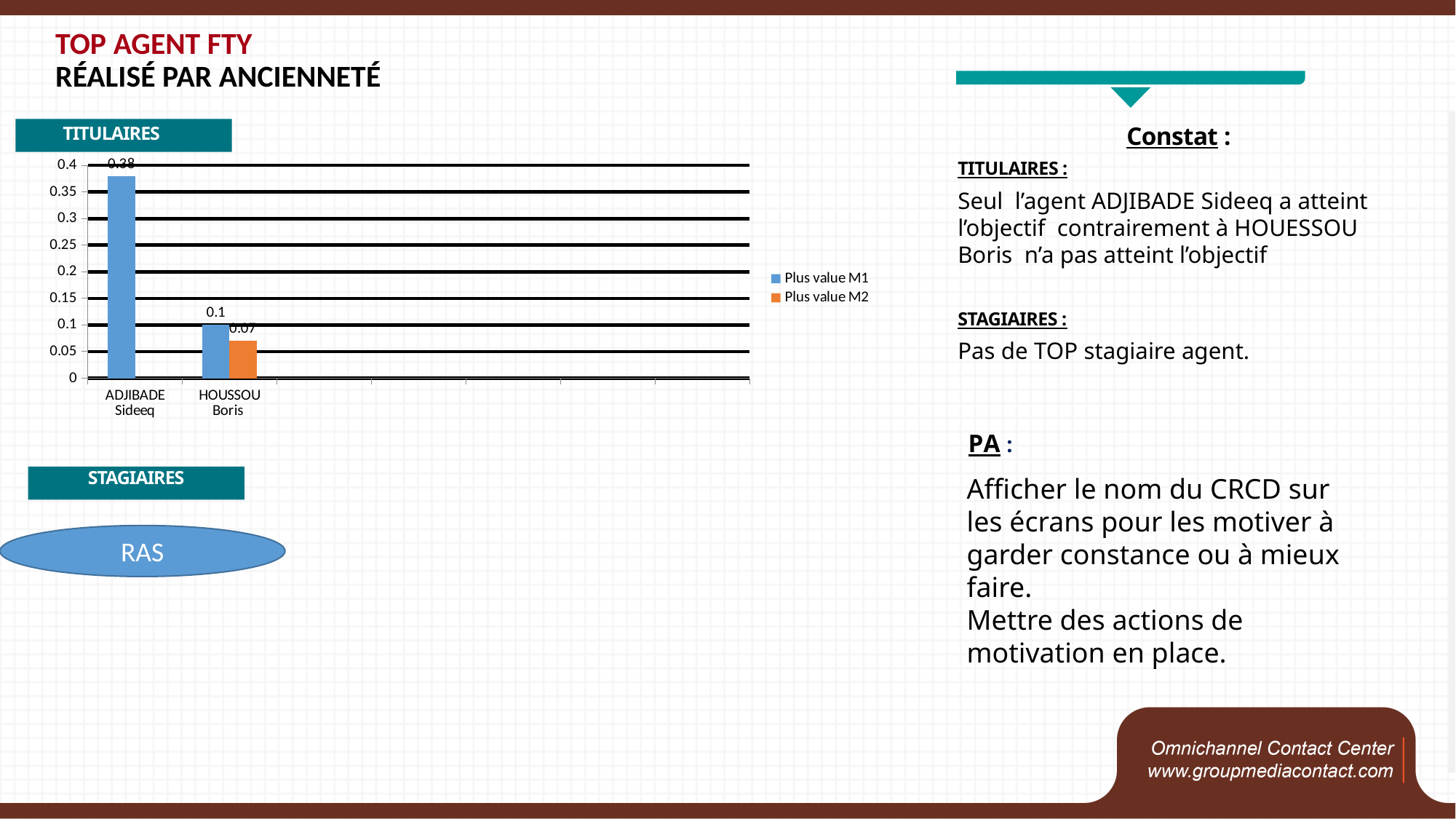
For HOUSSOU Boris, what is the difference between Plus value M1 and Plus value M2? 0.03 Which agent has the highest Plus value M1? ADJIBADE Sideeq What is the Plus value M1 for HOUSSOU Boris? 0.1 How many series does the chart legend list? 2 Which agent has the lowest Plus value M1? HOUSSOU Boris What is the Plus value M1 for ADJIBADE Sideeq? 0.38 What type of chart is shown under the TITULAIRES heading? Bar chart How many agents are shown on the x axis of the chart? 2 Is the Plus value M1 for ADJIBADE Sideeq greater or less than 0.3? greater Which is larger for HOUSSOU Boris: Plus value M1 or Plus value M2? Plus value M1 What is the Plus value M2 for HOUSSOU Boris? 0.07 What is the difference between the Plus value M1 of ADJIBADE Sideeq and that of HOUSSOU Boris? 0.28